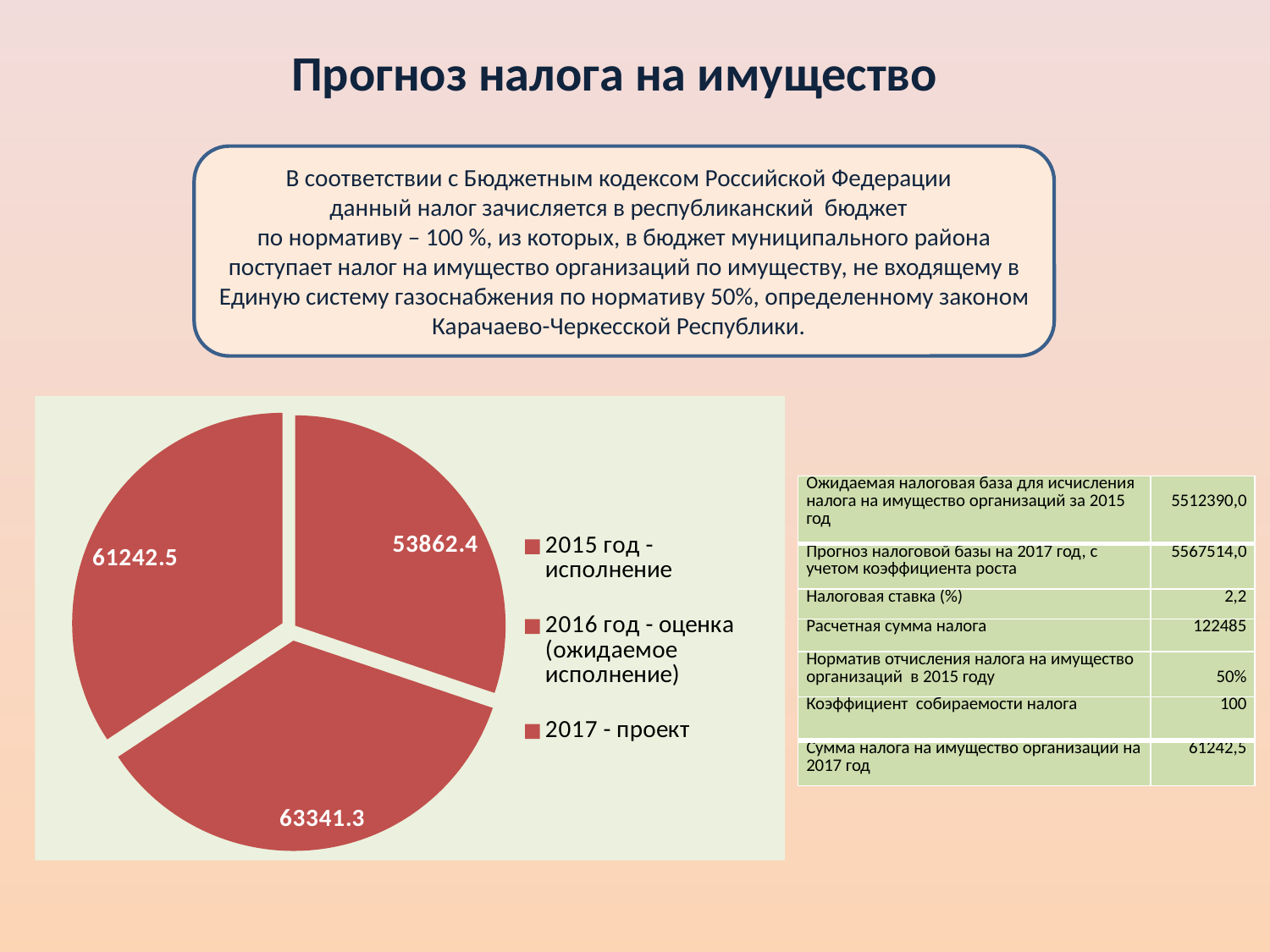
What is the value for "2017 - проект" in the pie chart? 61242.5 Which is larger in the pie chart: the value for 2017 - проект or the value for 2015 год - исполнение? 2017 - проект How many slices does the pie chart have? 3 What is the difference between the values for 2016 and 2015 in the pie chart? 9478.9 What is the difference between the values for 2016 and 2017 in the pie chart? 2098.8 Which category has the largest slice in the pie chart? 2016 год - оценка (ожидаемое исполнение) What type of chart is shown on the slide? Pie chart How many entries does the legend of the pie chart list? 3 Which category has the smallest slice in the pie chart? 2015 год - исполнение What is the total of all three values shown in the pie chart? 178446.2 What is the value for "2015 год - исполнение" in the pie chart? 53862.4 What is the value for "2016 год - оценка (ожидаемое исполнение)" in the pie chart? 63341.3